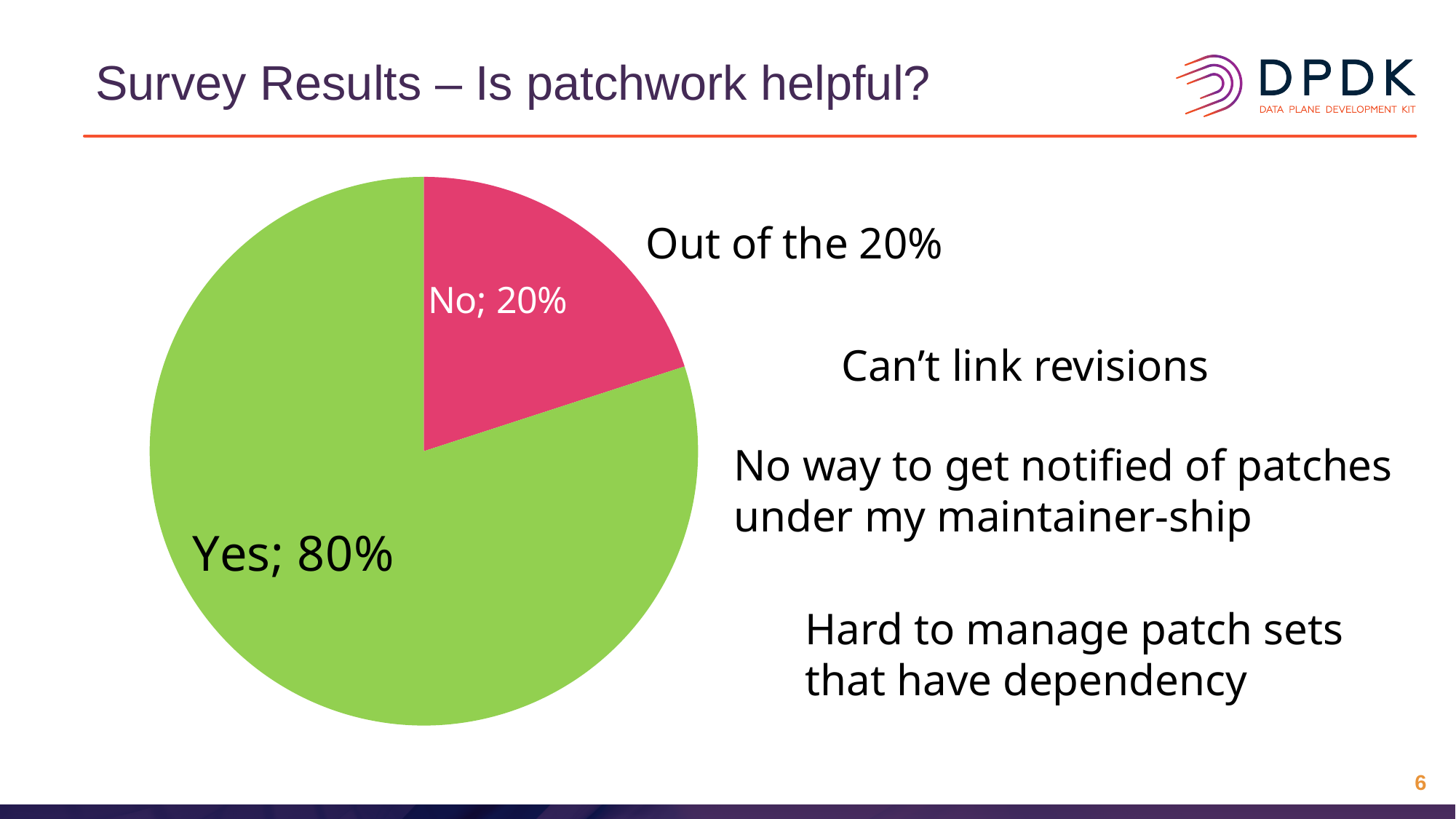
How many slices does the pie chart have? 2 What share of the pie does the "No" slice represent? 20% Which is larger, the "Yes" slice or the "No" slice? Yes Is the value for "No" greater or less than 50%? less What is the total of the two pie slices? 100% What colour is the "Yes" slice of the pie? green What kind of chart is shown on the slide? pie chart What is the difference in percentage points between the "Yes" and "No" slices? 60% What colour is the "No" slice of the pie? pink Which slice of the pie is the smallest? No Which slice of the pie is the largest? Yes What share of the pie does the "Yes" slice represent? 80%